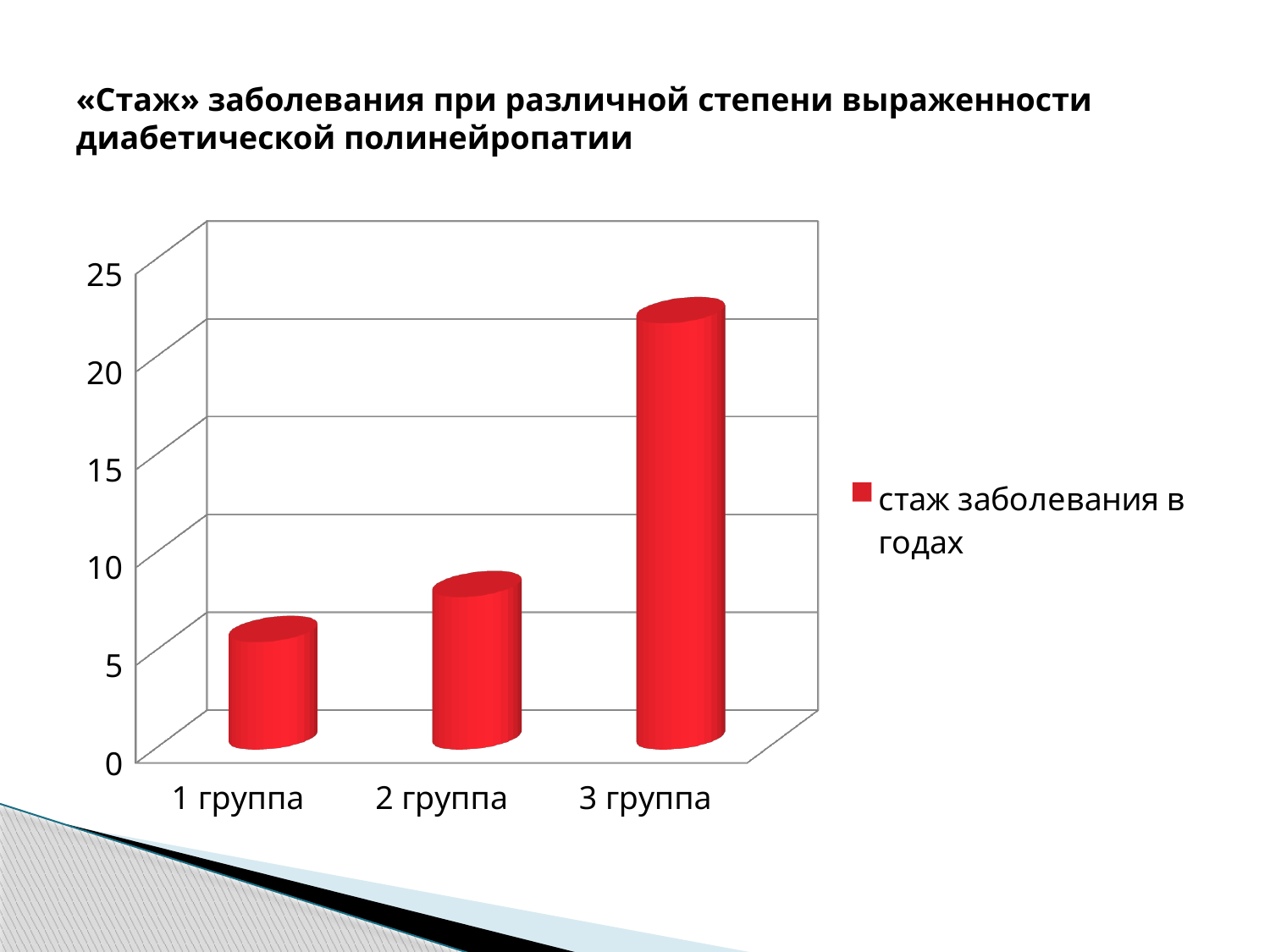
How many series does the legend list? 1 Is the value for 3 группа greater or less than 25? less Which group has the highest value? 3 группа What kind of chart is shown on the slide? bar chart Which is larger, the value for 1 группа or 2 группа? 2 группа What is the legend entry for the series shown? стаж заболевания в годах Which group has the lowest value? 1 группа Is the value for 1 группа greater or less than 10? less Do the values rise or fall from 1 группа to 3 группа? rise Is the value for 3 группа greater or less than 20? greater How many categories (groups) are shown on the x axis? 3